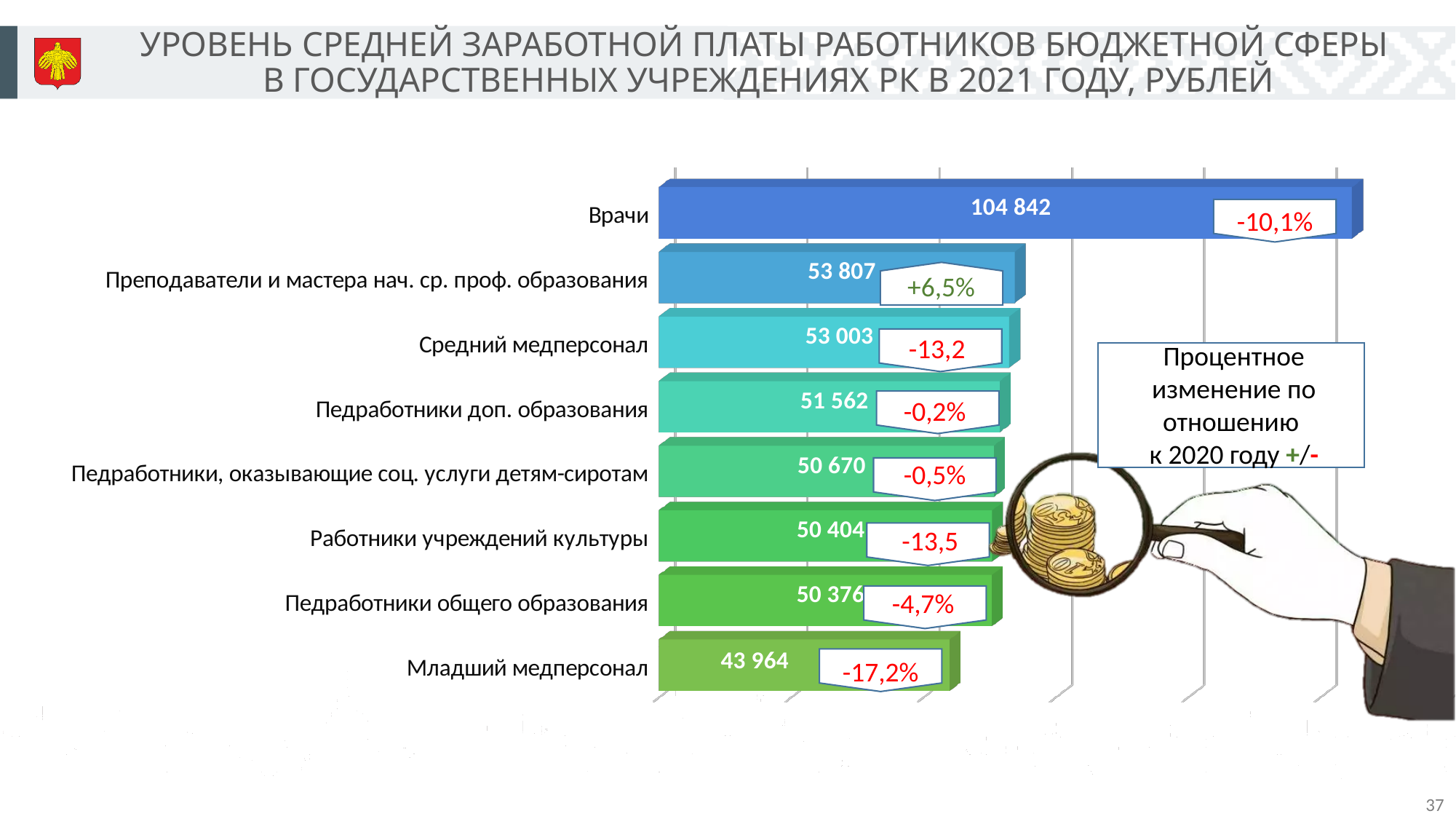
What is the average salary shown for Средний медперсонал? 53 003 Which category has the highest average salary? Врачи What is the difference between the average salary of Врачи and that of Младший медперсонал? 60 878 Which category is the only one with a positive percentage change relative to 2020? Преподаватели и мастера нач. ср. проф. образования What is the average salary shown for Младший медперсонал? 43 964 Which category has the lowest average salary? Младший медперсонал What percentage change relative to 2020 is shown for Преподаватели и мастера нач. ср. проф. образования? +6,5% What is the average salary shown for Врачи? 104 842 How many categories are shown in the chart? 8 What percentage change relative to 2020 is shown for Младший медперсонал? -17,2% Which is larger: the average salary of Педработники доп. образования or of Младший медперсонал? Педработники доп. образования What kind of chart is shown on the slide? Bar chart